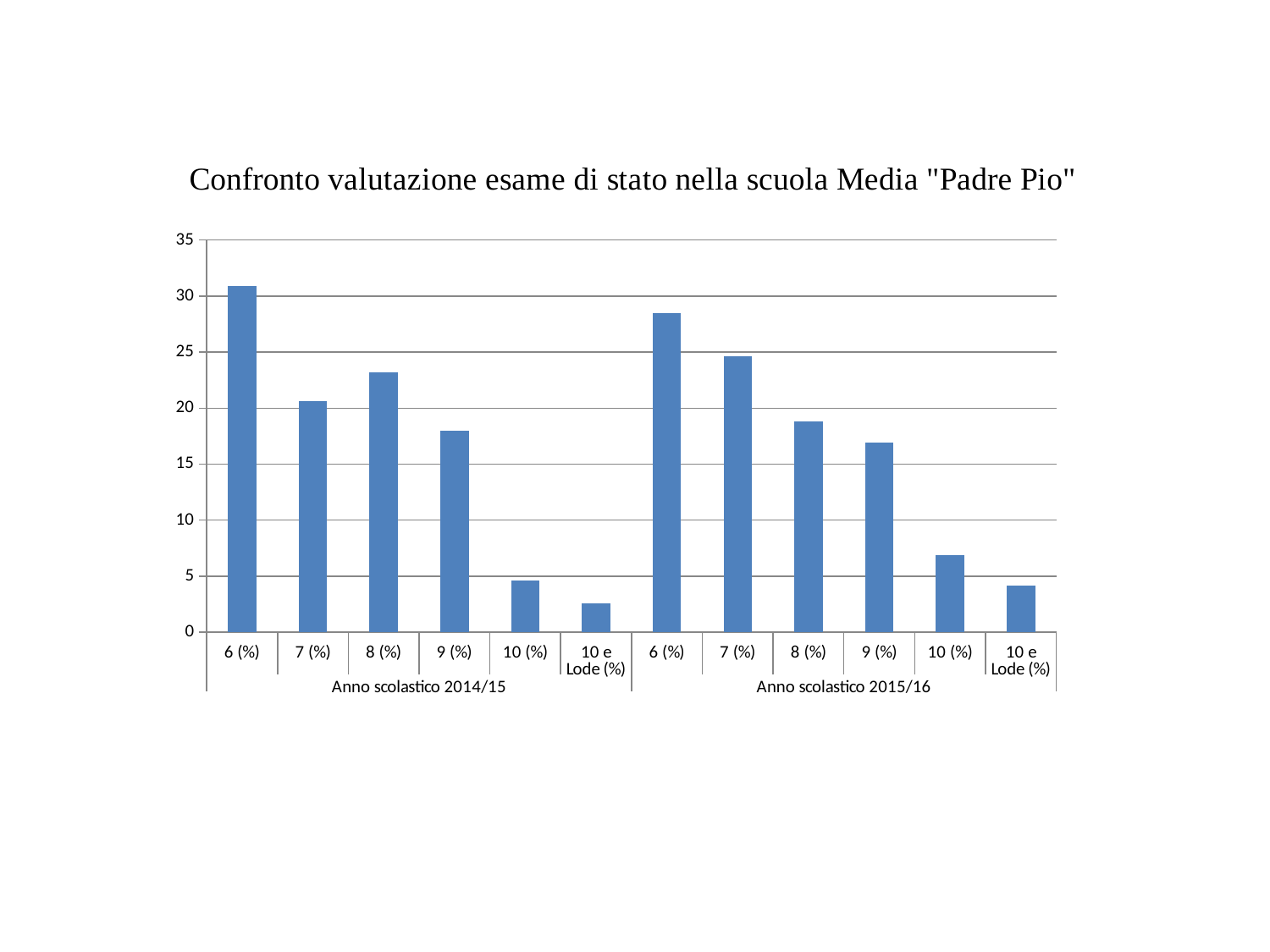
Within the Anno scolastico 2015/16 group, do the values rise or fall from 6 (%) to 10 e Lode (%)? fall Which category has the highest bar in the chart? 6 (%) in Anno scolastico 2014/15 Is the value for 10 (%) in Anno scolastico 2015/16 greater or less than 5? greater What is the title of the chart? Confronto valutazione esame di stato nella scuola Media "Padre Pio" Which is larger: the value for 8 (%) in Anno scolastico 2014/15 or 8 (%) in Anno scolastico 2015/16? 8 (%) in Anno scolastico 2014/15 Is the value for 10 (%) in Anno scolastico 2014/15 greater or less than 5? less Is the value for 7 (%) in Anno scolastico 2015/16 greater or less than 20? greater What kind of chart is shown on the slide? bar chart Which category has the lowest bar in the chart? 10 e Lode (%) in Anno scolastico 2014/15 How many bars are plotted in the chart in total? 12 Which is larger: the value for 7 (%) in Anno scolastico 2014/15 or 7 (%) in Anno scolastico 2015/16? 7 (%) in Anno scolastico 2015/16